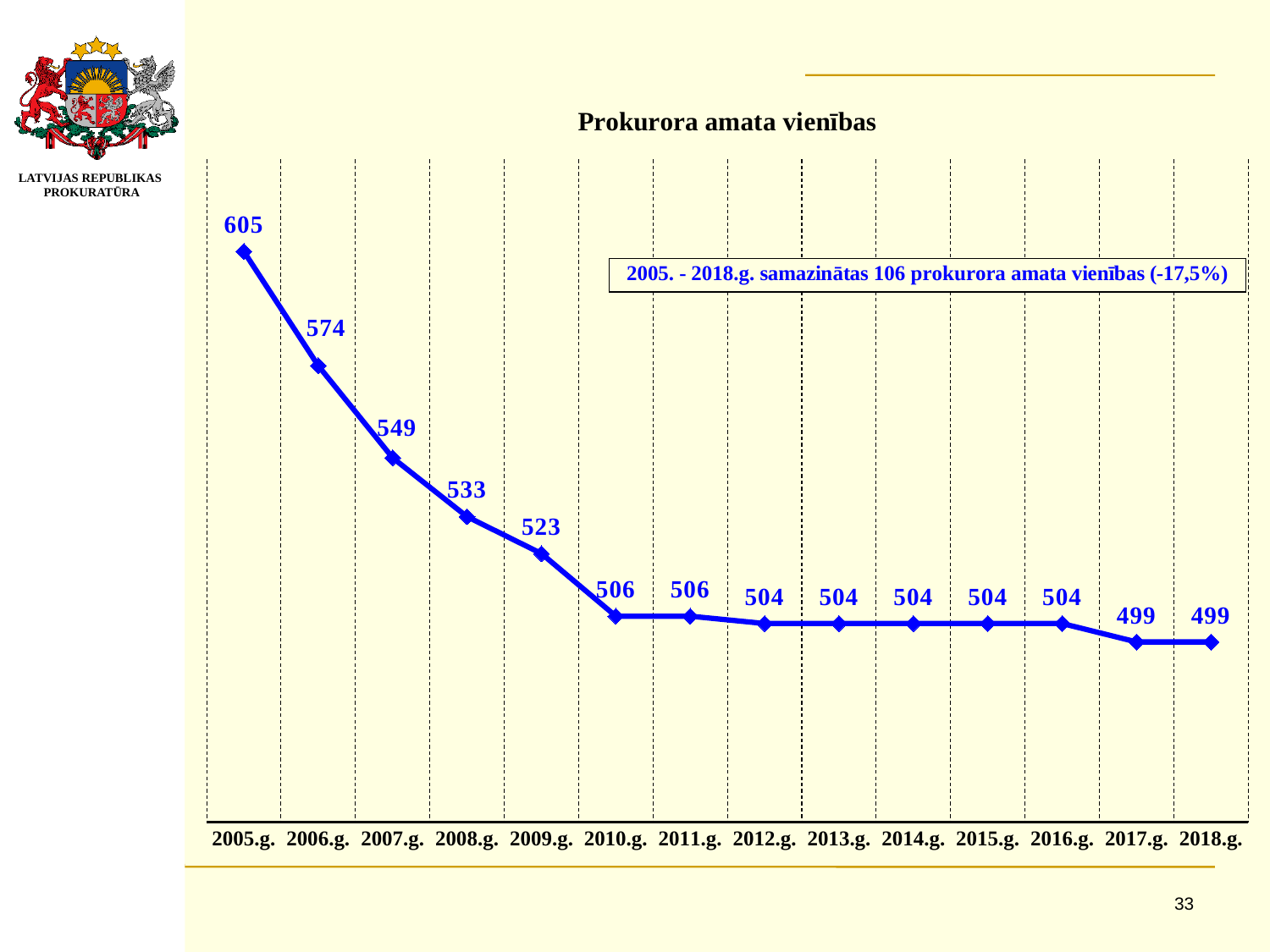
What kind of chart is this? line chart What is the difference between the values for 2005.g. and 2006.g.? 31 Which year has the highest value? 2005.g. Do the values rise or fall from 2005.g. to 2018.g.? fall What is the title of the chart? Prokurora amata vienības How many years are shown on the x axis? 14 What is the value for 2009.g.? 523 What is the value for 2018.g.? 499 Which is larger, the value for 2007.g. or the value for 2010.g.? 2007.g. What is the difference between the values for 2005.g. and 2018.g.? 106 What is the value for 2005.g.? 605 What is the lowest value shown on the chart? 499